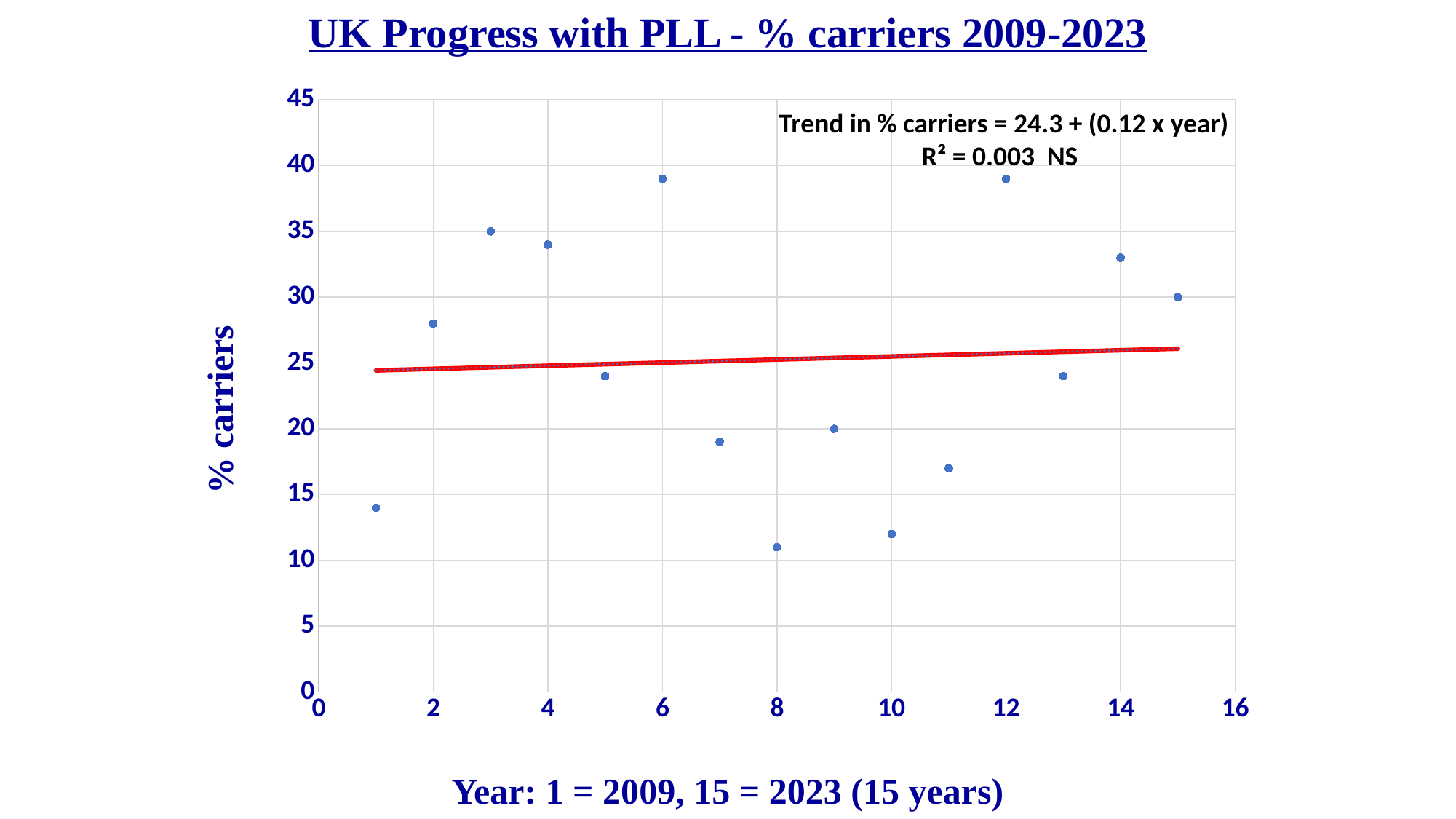
What R² value is shown for the trend line? 0.003 Is the value for year 1 greater or less than 15? less What is the % carriers value for year 3? 35 Which has a higher % carriers value, year 6 or year 7? year 6 Is the value for year 8 greater or less than 15? less What kind of chart is shown on the slide? scatter chart What is the % carriers value for year 9? 20 How many data points are plotted on the chart? 15 What is the % carriers value for year 15? 30 Is the value for year 14 greater or less than 30? greater Does the red trend line rise or fall as year increases? rises